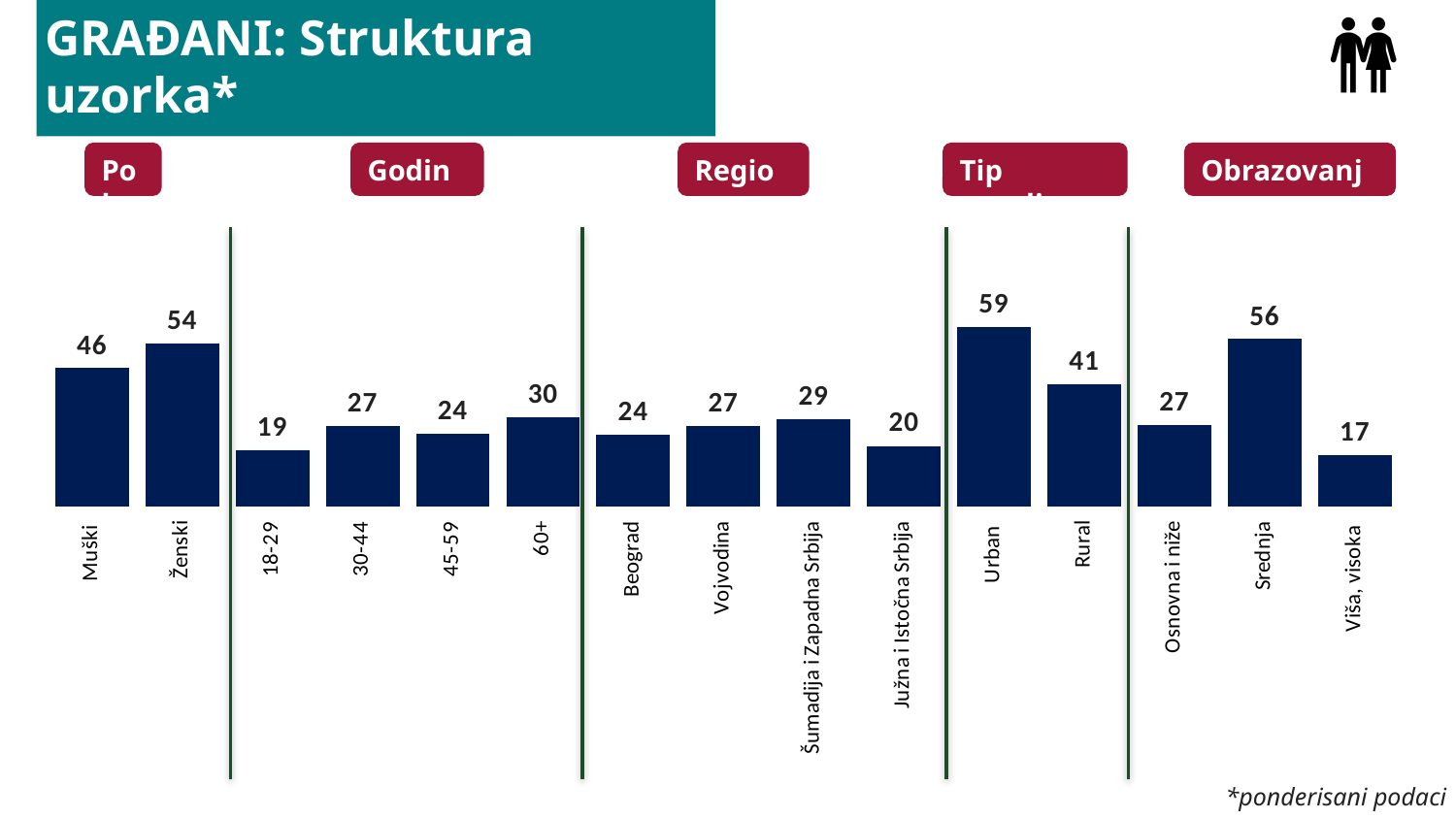
Which is larger, the value for Beograd or the value for Šumadija i Zapadna Srbija? Šumadija i Zapadna Srbija What is the difference between the values for Ženski and Muški? 8 What is the value for Muški? 46 How many bars are plotted on the chart in total? 15 What is the value for Viša, visoka? 17 What is the value for Vojvodina? 27 What kind of chart is shown on the slide? bar chart Which category has the lowest value on the chart? Viša, visoka What is the difference between the values for Urban and Rural? 18 What is the value for the 60+ age group? 30 Which is larger, the value for 18-29 or the value for 30-44? 30-44 Which category has the highest value on the chart? Urban